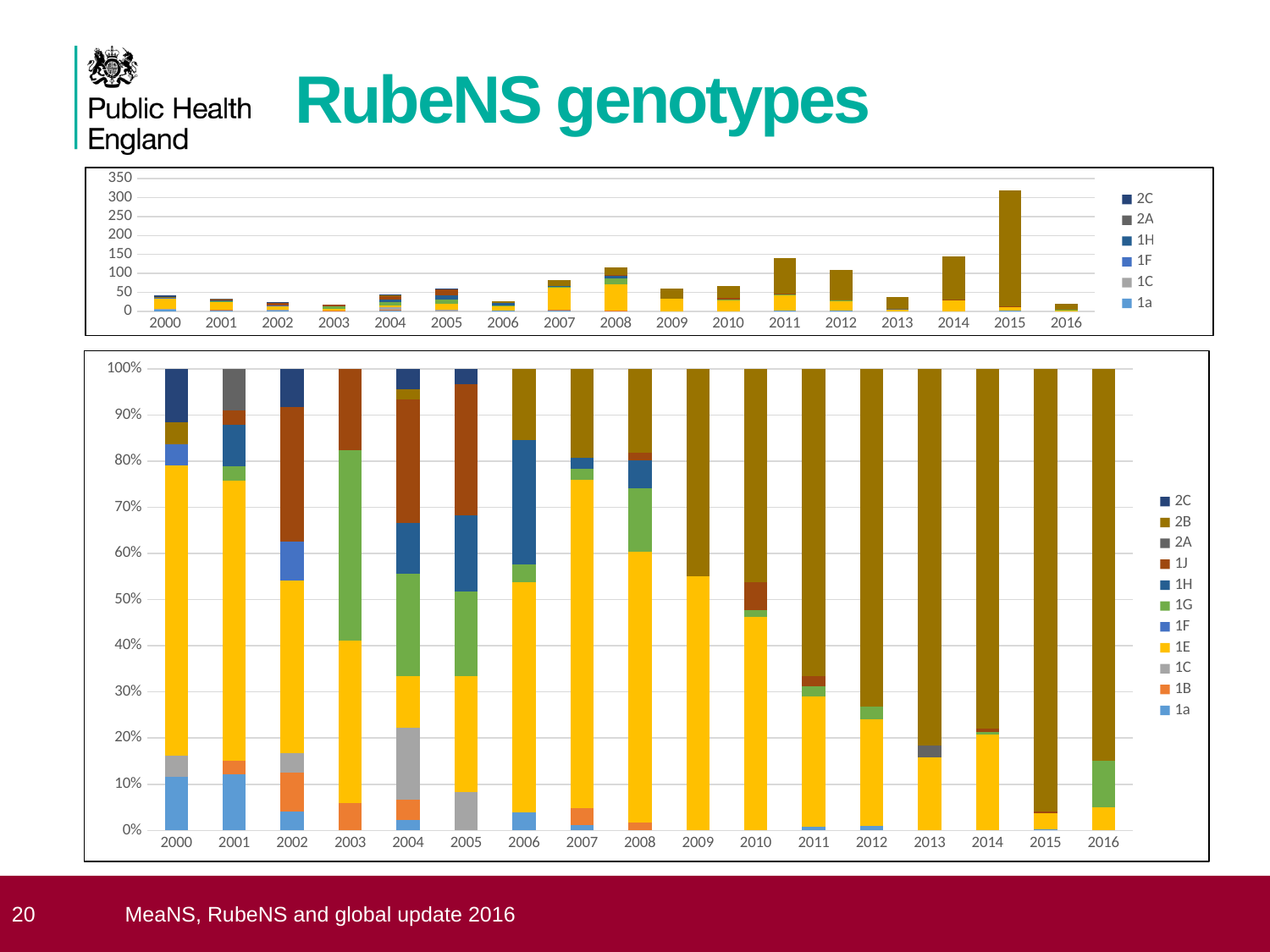
In the top chart, is the total for 2016 greater or less than 50? less In the top chart, is the total for 2015 greater or less than 300? greater In the top chart, which year has the highest total number of samples? 2015 In the bottom chart, which genotype accounts for the largest share of the 2015 bar? 2B In the bottom chart, is the share of genotype 2B in 2016 greater or less than 70%? greater What kind of chart is the top chart on the slide? Stacked bar chart What is the title of the slide containing the charts? RubeNS genotypes What kind of chart is the bottom chart on the slide? 100% stacked bar chart How many genotypes does the legend of the bottom chart list? 11 In the top chart, which year has the larger total, 2014 or 2015? 2015 How many years are shown on the x axis of the bottom chart? 17